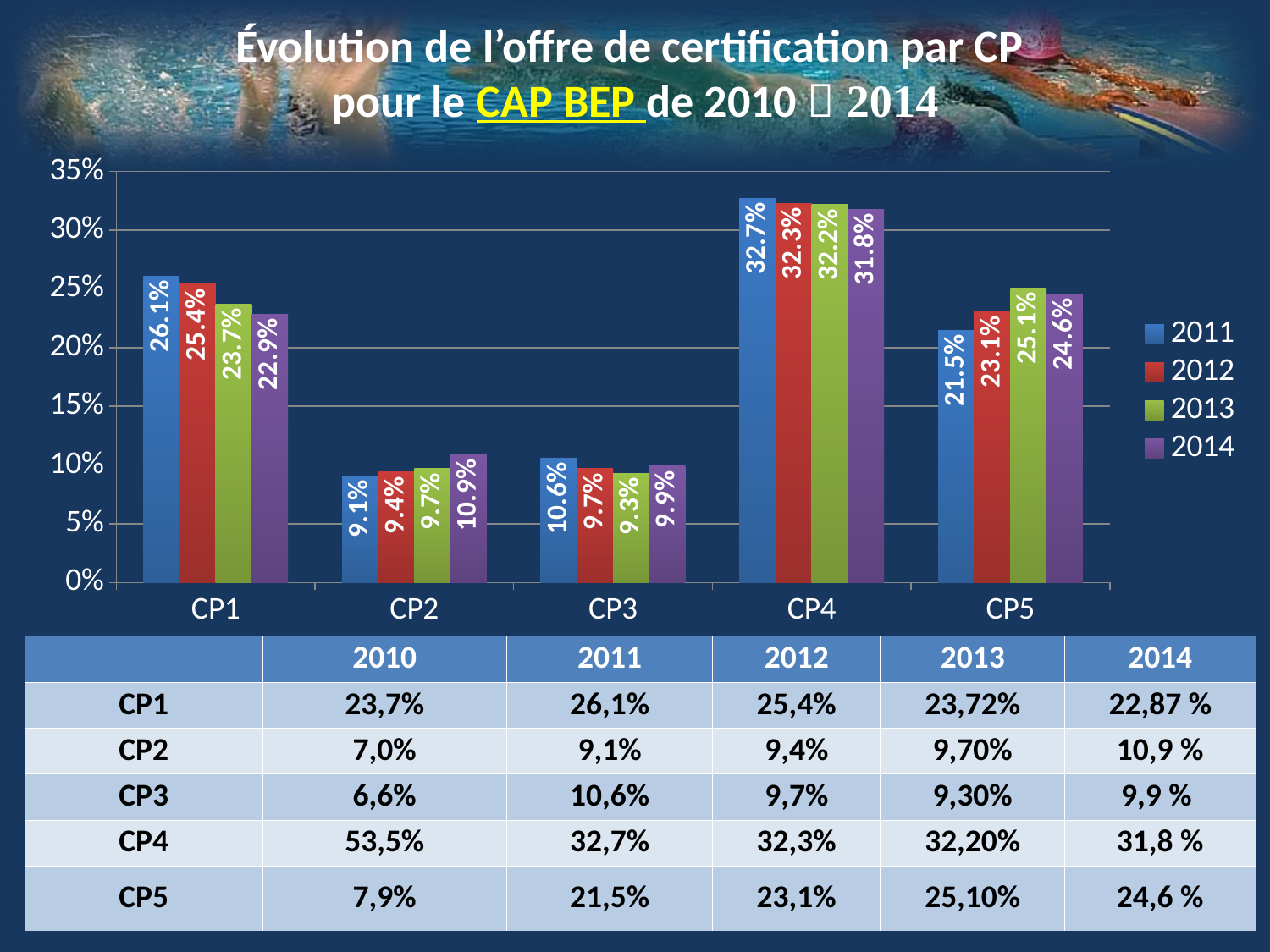
Do the values for CP1 rise or fall from 2011 to 2014? fall What is the value for CP2 in the 2014 series? 10.9% What is the value for CP4 in the 2011 series? 32.7% What kind of chart is shown on the slide? bar chart What is the difference between the 2011 and 2014 values for CP1? 3.2% How many categories are shown on the x axis? 5 Which is larger for CP3: the 2011 value or the 2014 value? 2011 Which category has the highest value in the 2012 series? CP4 How many series does the legend list? 4 What is the value for CP5 in the 2013 series? 25.1% Which category has the lowest value in the 2011 series? CP2 Is the value for CP5 in 2014 greater or less than 20%? greater